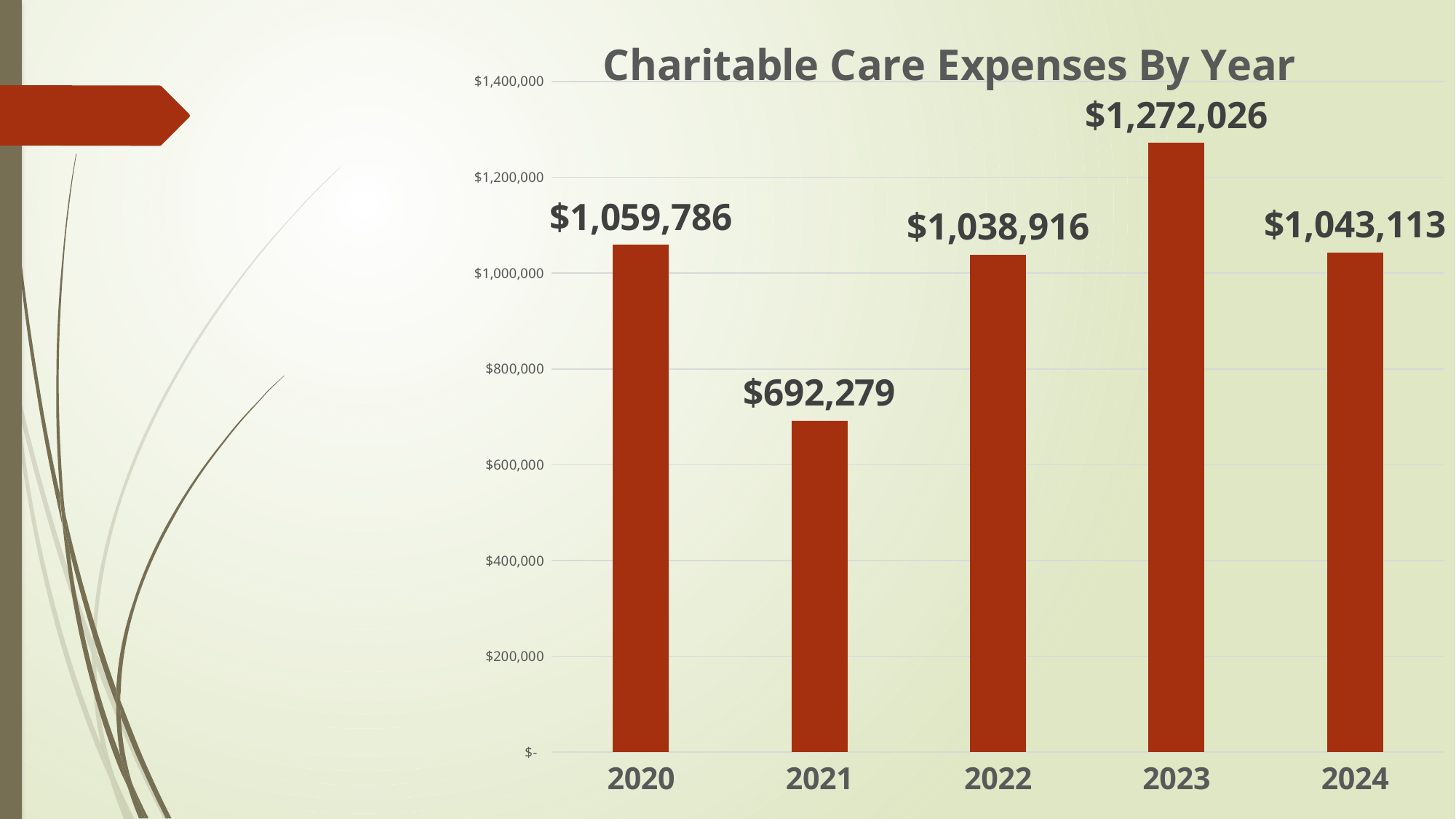
Is the value for 2021 greater or less than $800,000? less Which year has the highest charitable care expense? 2023 Which year has the lowest charitable care expense? 2021 What is the charitable care expense for 2023? $1,272,026 What is the title of the chart? Charitable Care Expenses By Year Which year has the larger charitable care expense, 2020 or 2022? 2020 What is the charitable care expense for 2020? $1,059,786 What kind of chart is shown on the slide? Bar chart What is the charitable care expense for 2021? $692,279 What is the charitable care expense for 2024? $1,043,113 What is the difference between the charitable care expenses for 2023 and 2021? $579,747 How many years are shown on the chart? 5